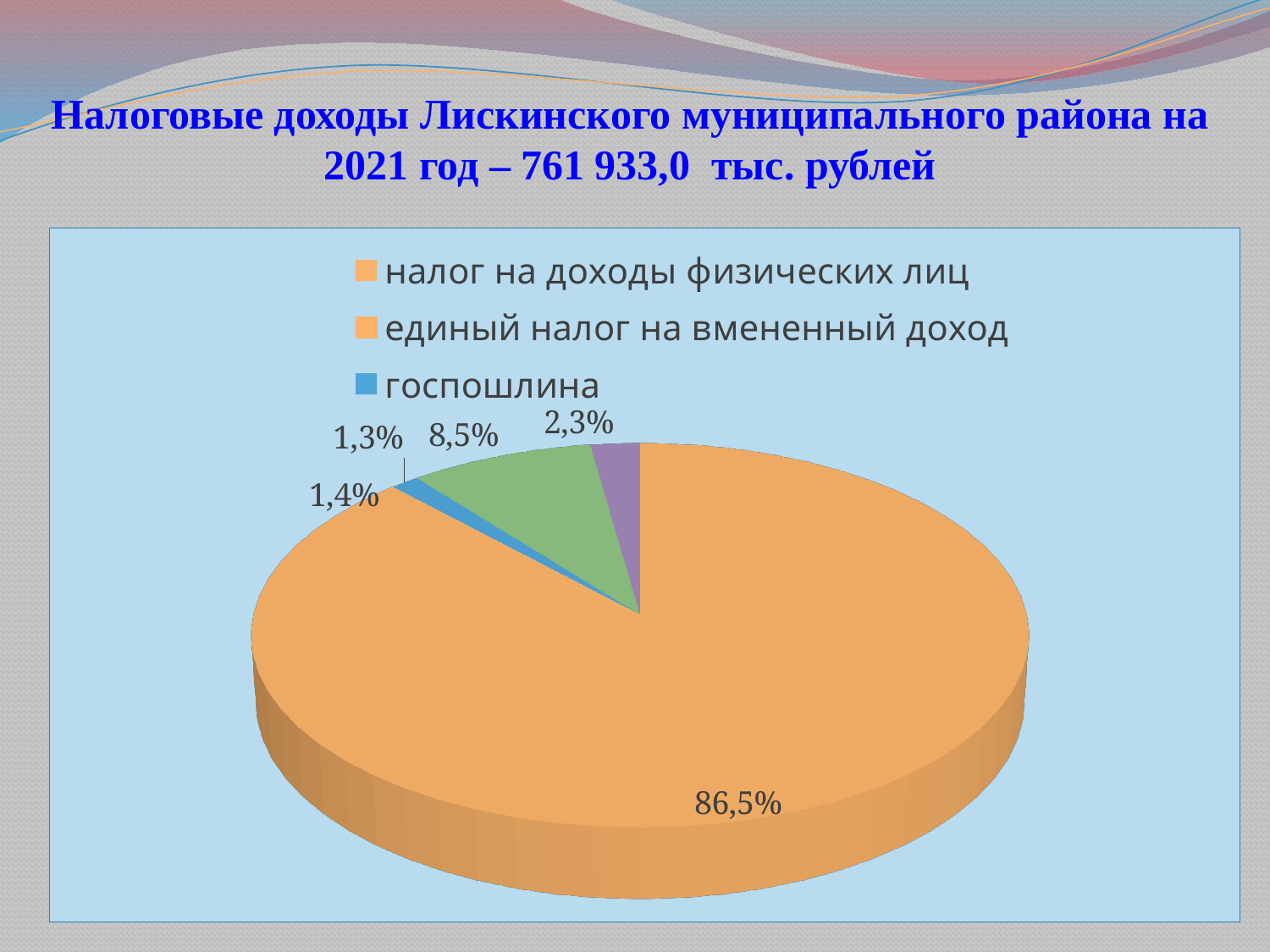
What is the difference between the largest slice (86,5%) and the 8,5% slice? 78,0% What kind of chart is shown on the slide? pie chart Which legend entry is marked with a blue colour? госпошлина Which is larger, the 8,5% slice or the 2,3% slice? 8,5% What is the smallest percentage labelled on the pie? 1,3% According to the slide title, what is the total tax revenue of the Liskinsky municipal district for 2021? 761 933,0 тыс. рублей What is the share of the largest slice of the pie? 86,5% How many entries does the legend list? 3 How many percentage labels are shown on the pie? 5 What is the second largest share labelled on the pie? 8,5% What is the difference between the 2,3% slice and the 1,3% slice? 1,0%